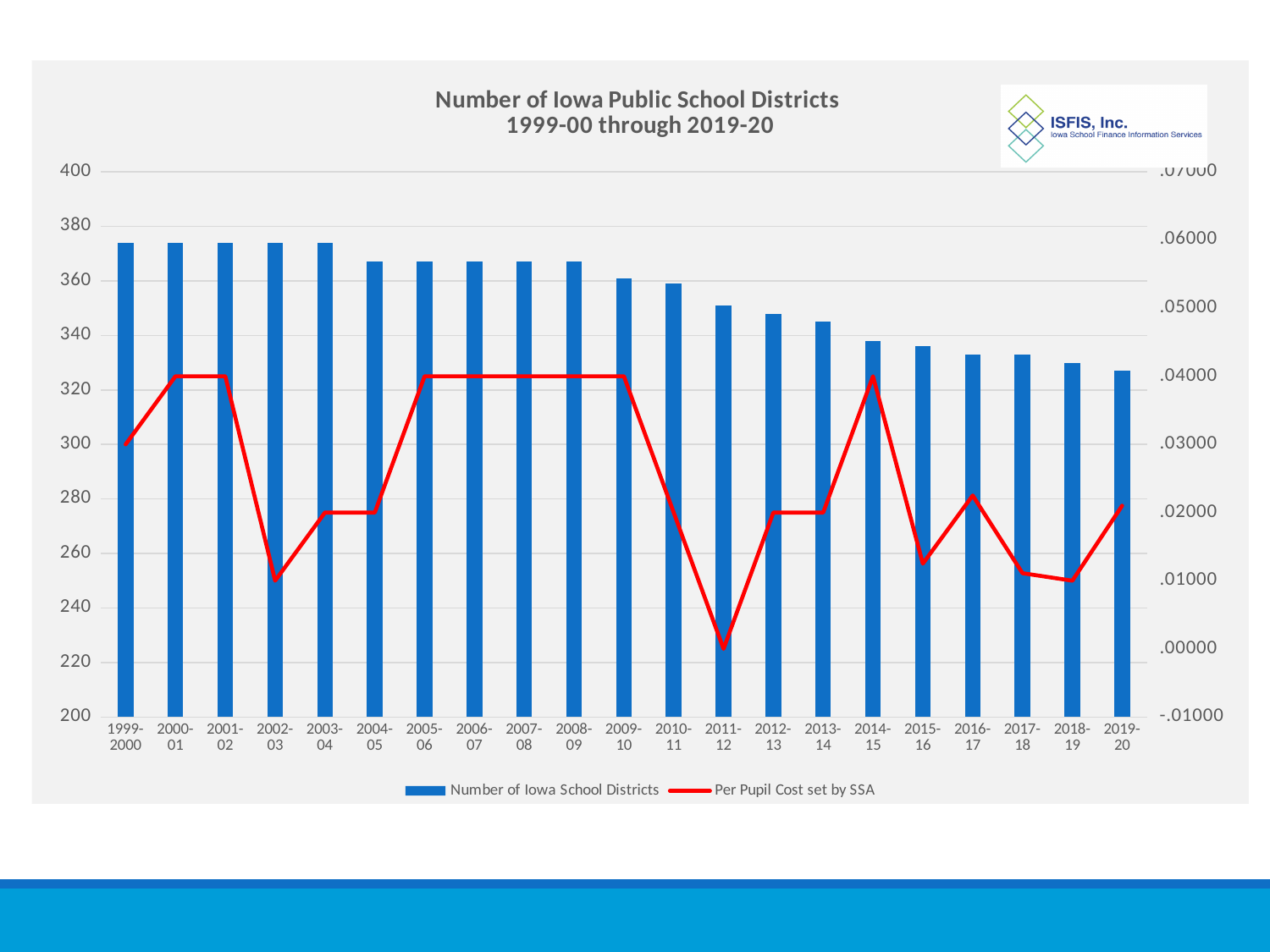
Does the Number of Iowa School Districts generally rise or fall from 1999-2000 to 2019-20? fall Is the Number of Iowa School Districts for 2019-20 greater or less than 340? less How many series does the legend list? 2 What is the title of the chart? Number of Iowa Public School Districts 1999-00 through 2019-20 What kind of chart is used for the Number of Iowa School Districts series? bar chart Which school year has the lowest Number of Iowa School Districts? 2019-20 Is the Number of Iowa School Districts for 1999-2000 greater or less than 360? greater What is the Per Pupil Cost set by SSA for 2002-03? .01000 What is the Per Pupil Cost set by SSA for 2005-06? .04000 In which school year is the Per Pupil Cost set by SSA lowest? 2011-12 How many school years are shown on the x axis? 21 What is the Per Pupil Cost set by SSA for 2011-12? .00000